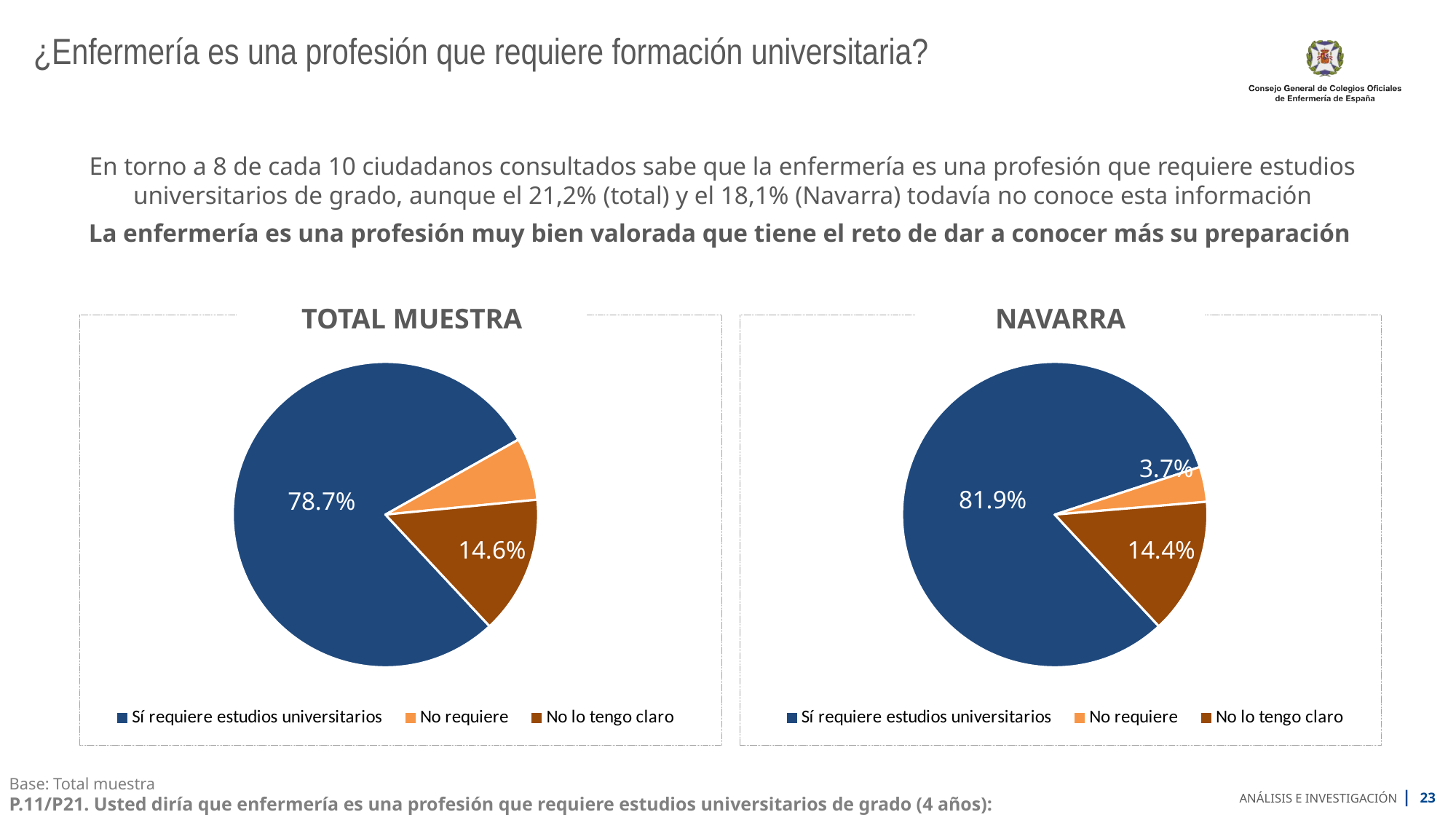
In the NAVARRA chart, what percentage of respondents said 'Sí requiere estudios universitarios'? 81.9% In the TOTAL MUESTRA chart, what percentage of respondents said 'Sí requiere estudios universitarios'? 78.7% In the NAVARRA chart, what percentage of respondents said 'No lo tengo claro'? 14.4% Which chart shows a larger share for 'Sí requiere estudios universitarios', TOTAL MUESTRA or NAVARRA? NAVARRA What is the difference in percentage points between the 'Sí requiere estudios universitarios' share in the NAVARRA chart and in the TOTAL MUESTRA chart? 3.2 percentage points How many slices does the NAVARRA pie chart have? 3 In the TOTAL MUESTRA chart, what percentage of respondents said 'No lo tengo claro'? 14.6% What type of chart is used for TOTAL MUESTRA? Pie chart In the NAVARRA chart, which response has the smallest share? No requiere In the TOTAL MUESTRA chart, which response has the smallest share? No requiere In the NAVARRA chart, what percentage of respondents said 'No requiere'? 3.7% In the TOTAL MUESTRA chart, which response has the largest share? Sí requiere estudios universitarios